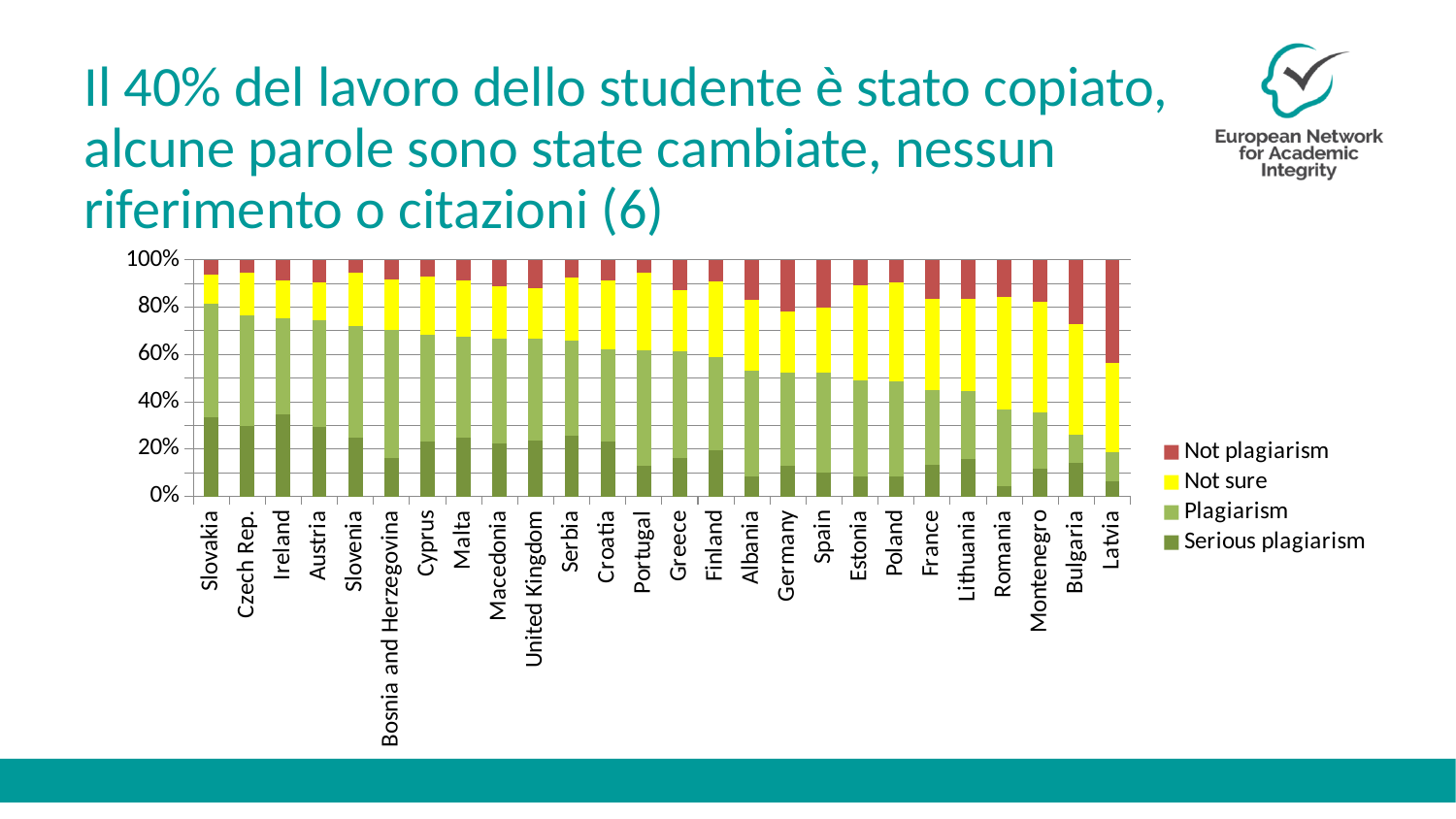
Which series is shown in yellow? Not sure Which has the larger Serious plagiarism share, Slovakia or Latvia? Slovakia How many series does the legend list? 4 Does the Serious plagiarism share generally rise or fall from left to right across the countries? fall What are the four legend entries of the chart? Not plagiarism, Not sure, Plagiarism, Serious plagiarism Is the Serious plagiarism value for Romania greater or less than 20%? less How many countries are shown along the x axis? 26 What kind of chart is shown on the slide? stacked bar chart Which has the larger Not plagiarism share, Latvia or Slovakia? Latvia Is the Not plagiarism value for Latvia greater or less than 20%? greater Is the Serious plagiarism value for Slovakia greater or less than 20%? greater Which country has the largest Not plagiarism share? Latvia